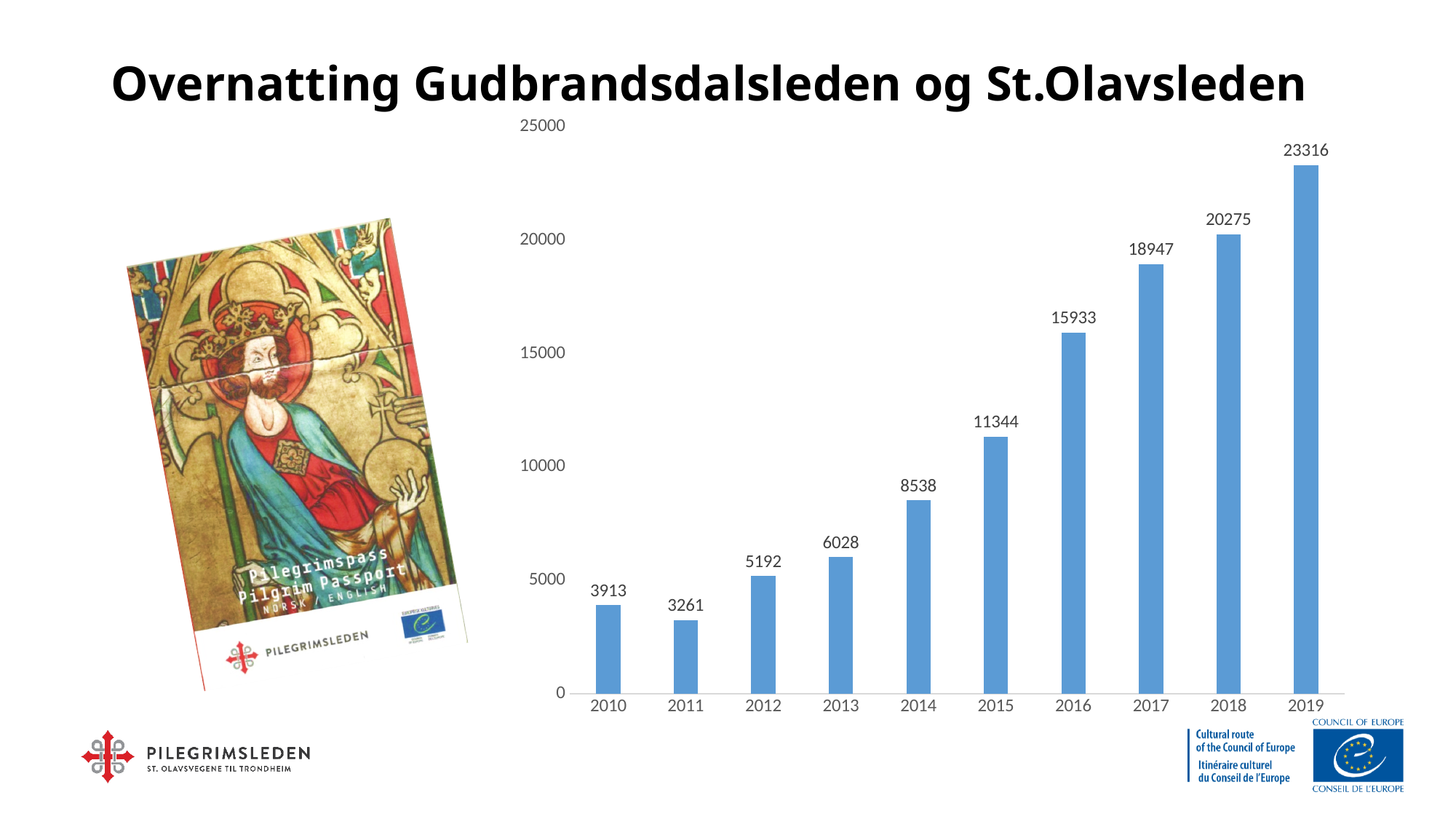
What is the difference between the values for 2019 and 2018? 3041 Which is larger, the value for 2012 or the value for 2011? 2012 Which year has the highest value? 2019 Which year has the lowest value? 2011 Is the value for 2016 greater or less than 15000? greater What is the value for 2015? 11344 Do the values generally rise or fall from 2011 to 2019? rise What kind of chart is shown on the slide? bar chart How many years are shown on the x axis? 10 What is the value for 2019? 23316 What is the value for 2010? 3913 What is the difference between the values for 2014 and 2013? 2510